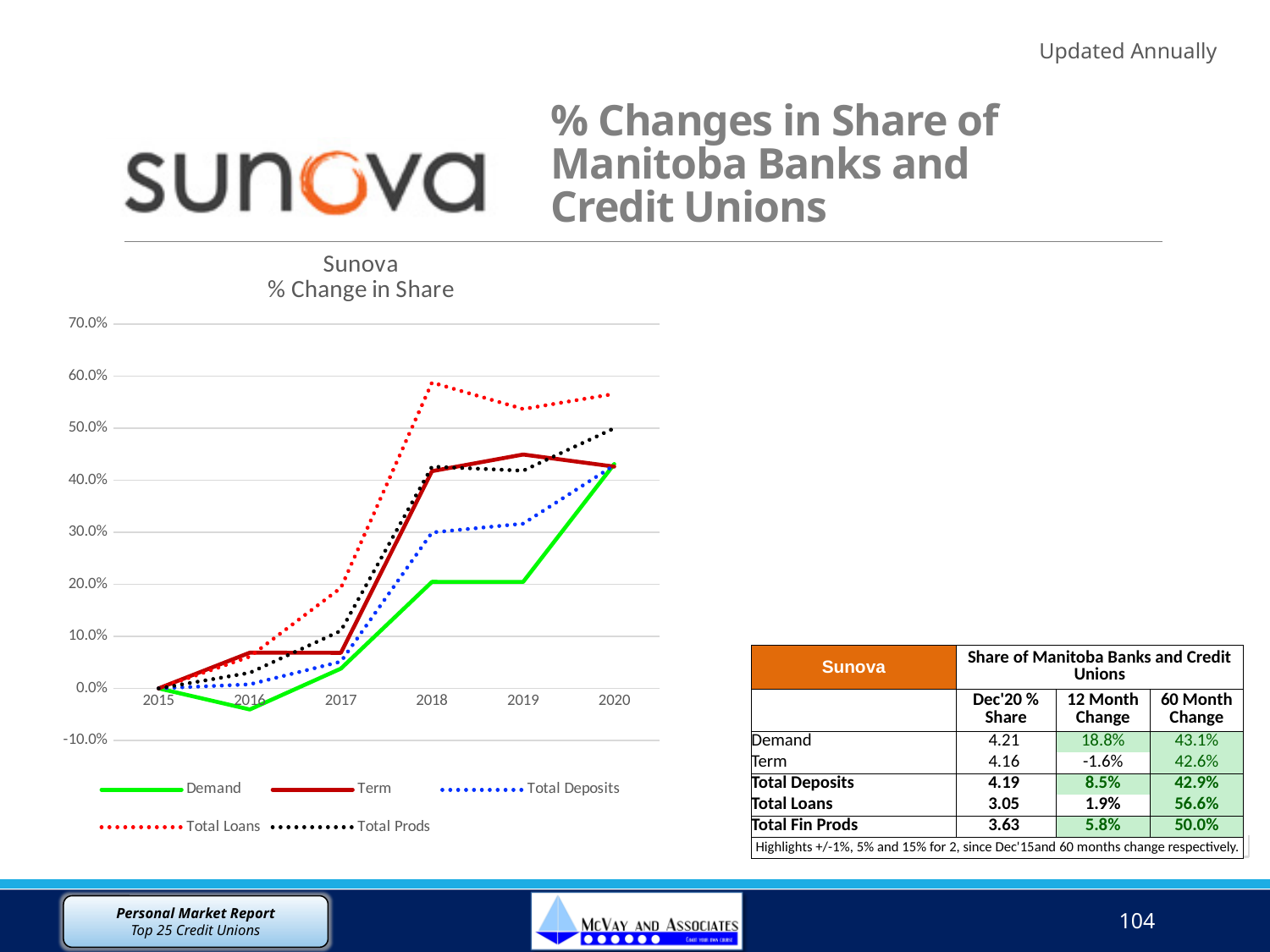
What is the title of the chart? Sunova % Change in Share How many series does the chart legend list? 5 What kind of chart is shown on the slide? line chart What is the value for Demand in 2015? 0.0% Is the value for Term in 2019 greater or less than 40%? greater How many years are plotted along the x axis of the chart? 6 In 2018, which is larger: Total Loans or Total Deposits? Total Loans Does the Demand series rise or fall from 2017 to 2018? rise Which series has the highest value in 2020? Total Loans Is the value for Total Loans in 2018 greater or less than 50%? greater Which series has the lowest value in 2016? Demand Is the value for Demand in 2019 greater or less than 30%? less